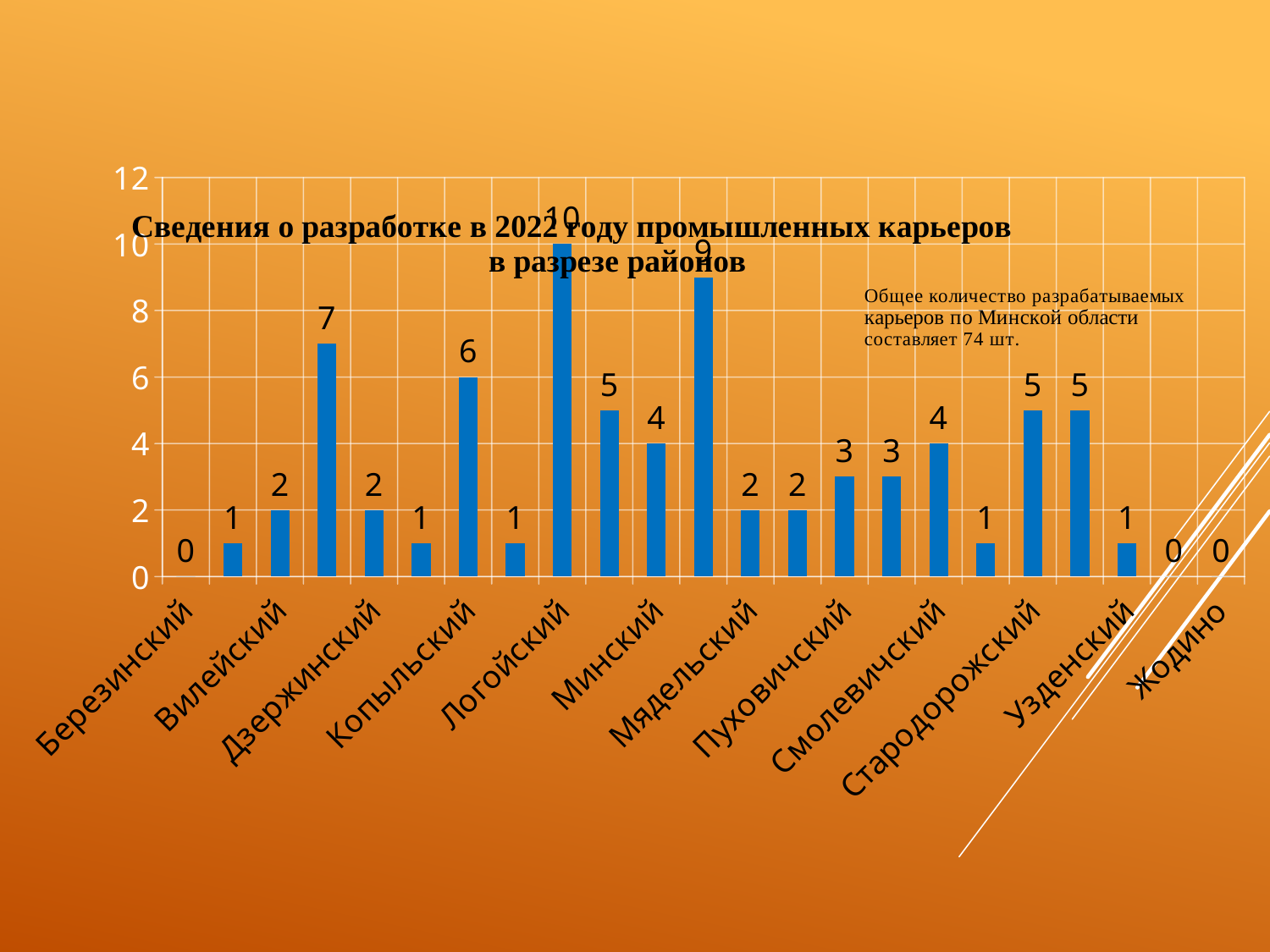
What is the maximum value shown on the vertical axis? 12 What is the value for Стародорожский? 5 What is the value for Логойский? 10 What is the value for Жодино? 0 What is the difference between the value for Логойский and the value for Копыльский? 4 What type of chart is shown on the slide? bar chart What is the value for Копыльский? 6 What is the highest value shown in the chart? 10 How many bars (districts) are plotted in the chart? 23 What is the value for Березинский? 0 Which has a larger value, Логойский or Стародорожский? Логойский According to the text on the slide, what is the total number of quarries being developed in the Minsk region? 74 шт.